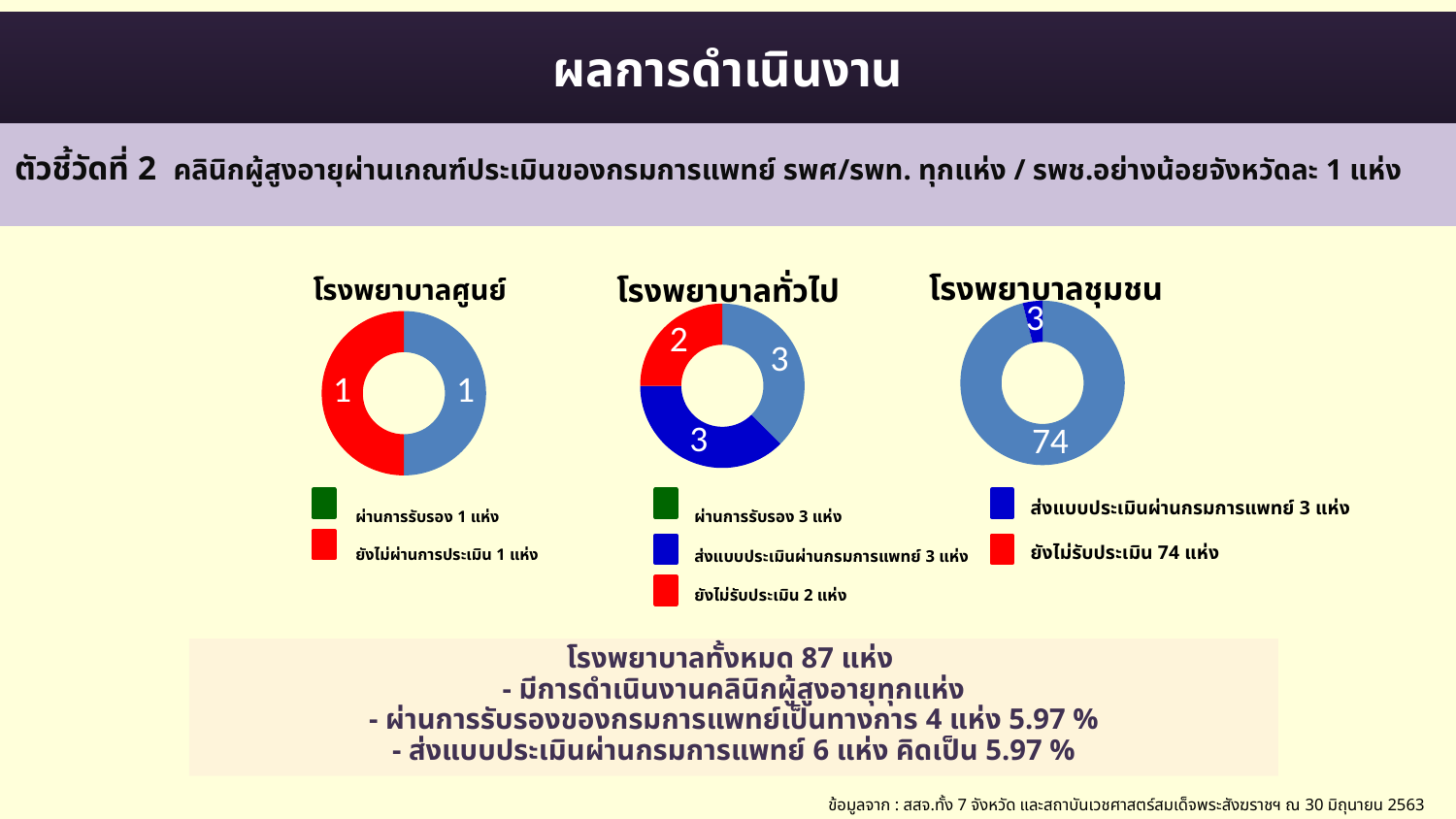
What is the title of the middle chart on the slide? โรงพยาบาลทั่วไป What kind of chart is used for โรงพยาบาลศูนย์ on the slide? Donut (pie) chart In the โรงพยาบาลชุมชน chart, which slice is larger, the one labelled 3 or the one labelled 74? 74 In the โรงพยาบาลทั่วไป chart, what is the value labelled on the red slice? 2 According to the legend of the โรงพยาบาลชุมชน chart, how many hospitals are ยังไม่รับประเมิน? 74 แห่ง In the โรงพยาบาลทั่วไป chart, how many slices are there? 3 In the โรงพยาบาลชุมชน chart, what is the value of the smallest slice? 3 In the โรงพยาบาลทั่วไป chart, what is the total of all slice values? 8 In the โรงพยาบาลศูนย์ chart, what share of the total does the red slice represent? 50% How many legend entries are listed under the โรงพยาบาลทั่วไป chart? 3 In the โรงพยาบาลชุมชน chart, what is the difference between the two slice values? 71 In the โรงพยาบาลชุมชน chart, what is the value of the largest slice? 74